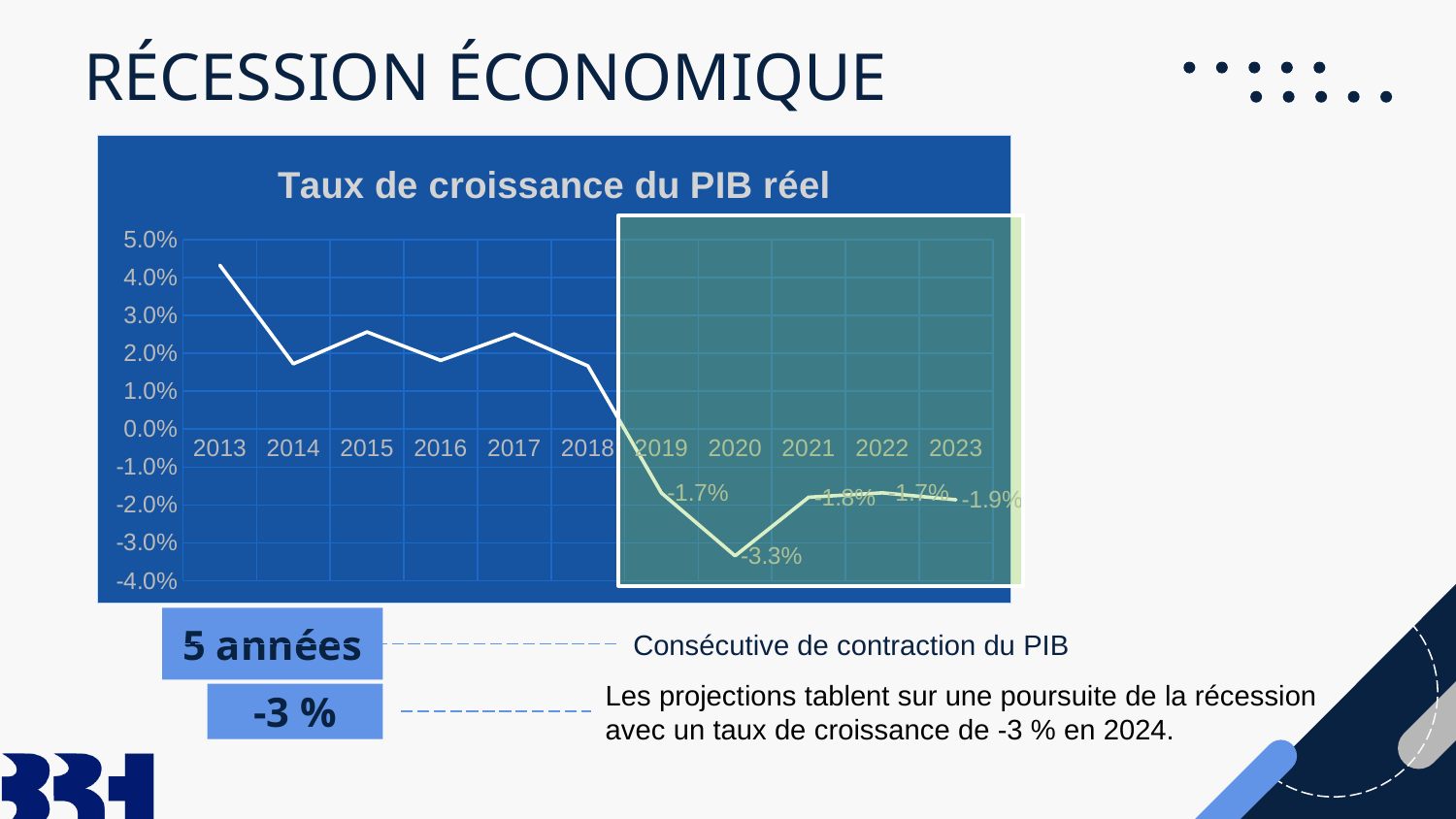
What is the real GDP growth rate shown for 2020? -3.3% What is the difference between the growth rates for 2019 and 2020? 1.6 percentage points What is the real GDP growth rate shown for 2022? -1.7% Which year has the lowest real GDP growth rate on the chart? 2020 Is the growth rate for 2013 greater or less than 4.0%? greater What is the title of the chart? Taux de croissance du PIB réel Which year has the highest real GDP growth rate on the chart? 2013 What kind of chart is shown on the slide? line chart What is the real GDP growth rate shown for 2023? -1.9% What is the real GDP growth rate shown for 2019? -1.7% How many years are plotted on the x axis of the chart? 11 Does the growth rate rise or fall from 2017 to 2020? fall